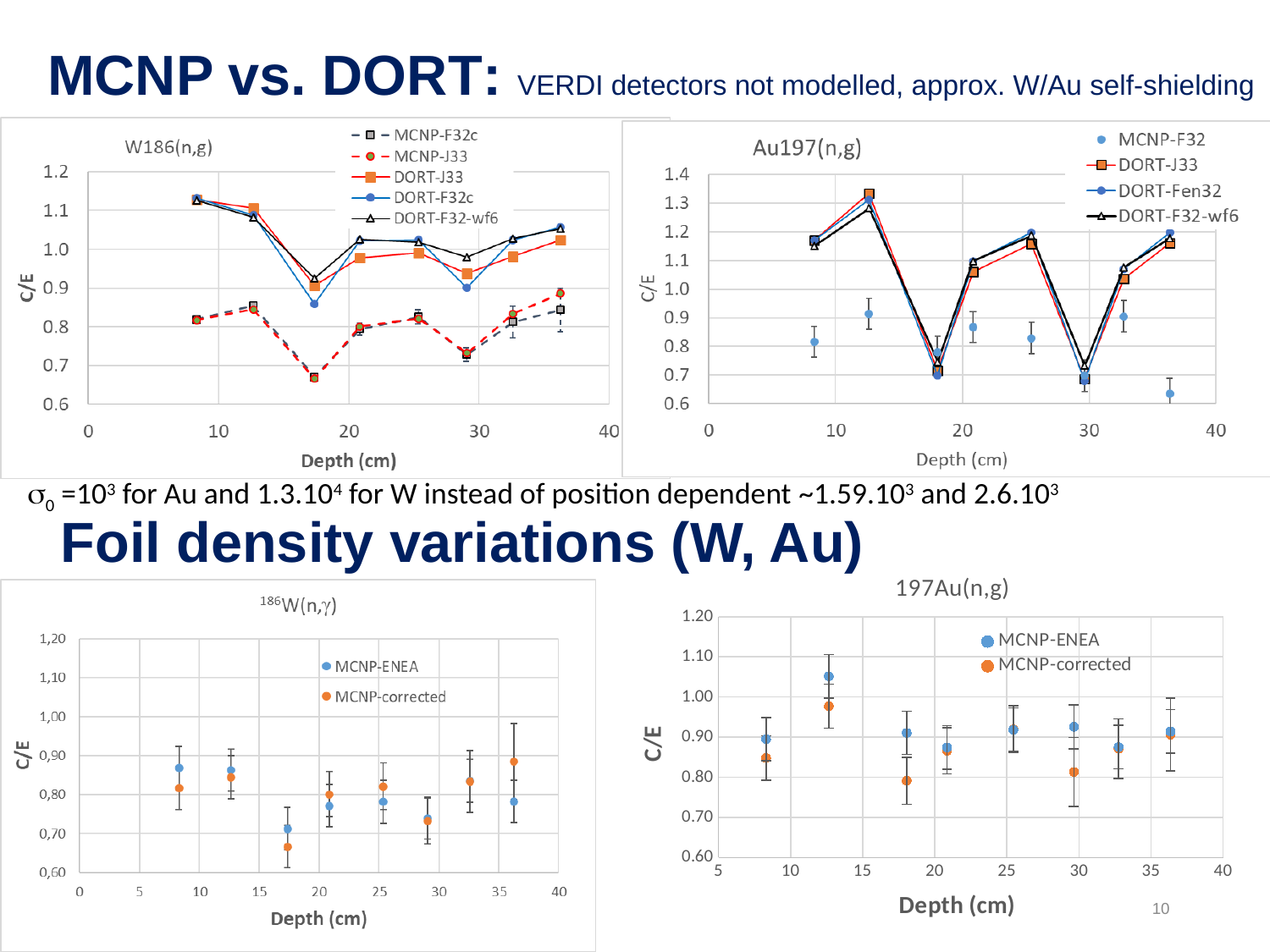
In the top-right Au197(n,g) chart, is the DORT-J33 value at a depth of about 12.5 cm greater or less than 1.3? greater How many depth points are plotted for the MCNP-ENEA series in the bottom-left 186W(n,γ) chart? 8 What is the x-axis label of the bottom-right 197Au(n,g) chart? Depth (cm) In the bottom-right 197Au(n,g) chart, is the MCNP-ENEA value at a depth of about 12.5 cm greater or less than 1.00? greater In the top-right Au197(n,g) chart, at a depth of about 8 cm, which series has the larger C/E value, MCNP-F32 or DORT-J33? DORT-J33 In the top-right Au197(n,g) chart, which series has the lowest C/E value at the deepest point (around 36 cm)? MCNP-F32 How many series does the legend of the top-right Au197(n,g) chart list? 4 How many series does the legend of the top-left W186(n,g) chart list? 5 In the bottom-right 197Au(n,g) chart, at a depth of about 12.5 cm, which series has the larger C/E value, MCNP-ENEA or MCNP-corrected? MCNP-ENEA How many series does the legend of the bottom-right 197Au(n,g) chart list? 2 In the top-left W186(n,g) chart, is the MCNP-J33 value at a depth of about 17 cm greater or less than 0.7? less